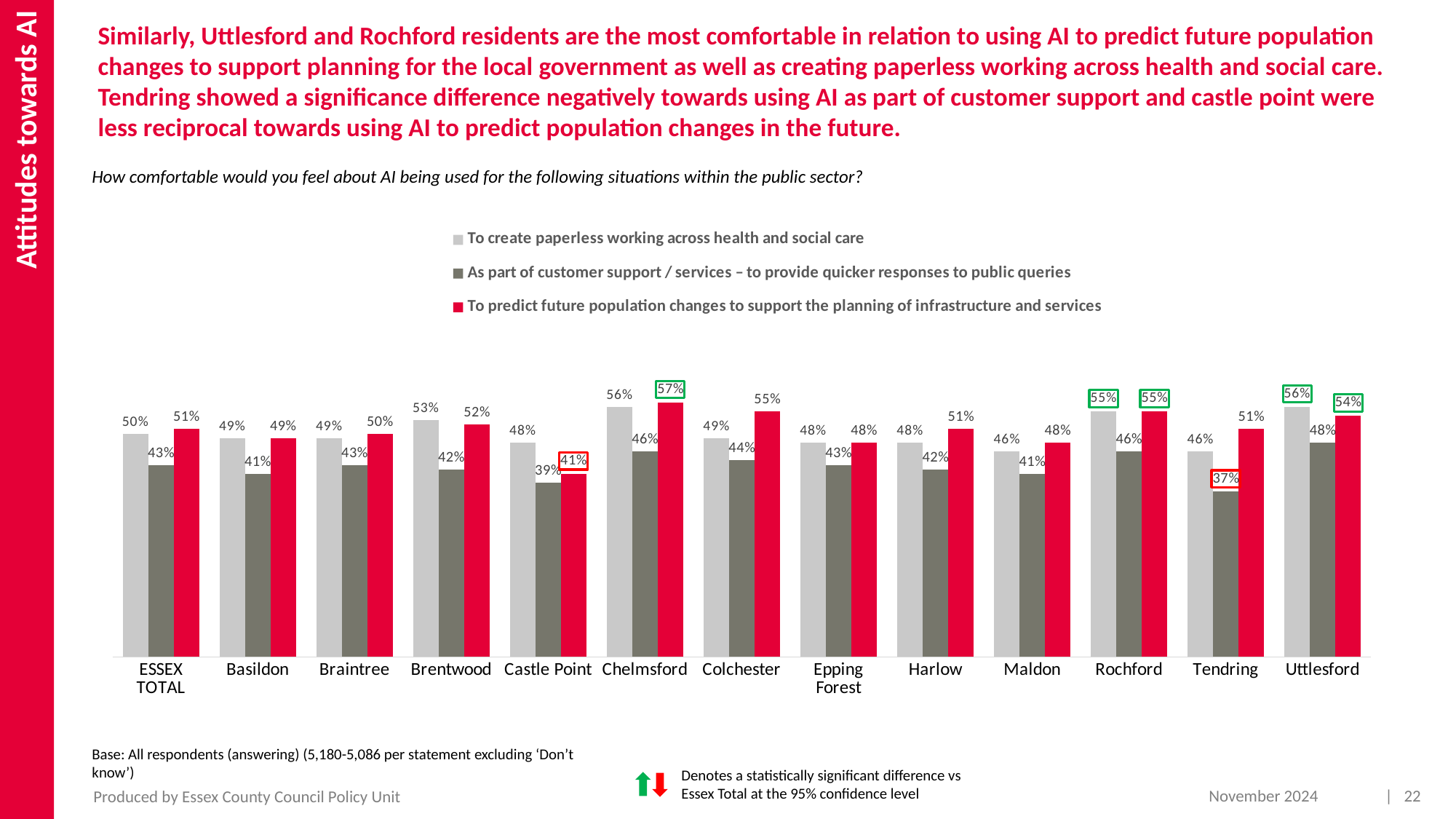
What is the value for ESSEX TOTAL for 'To create paperless working across health and social care'? 50% How many areas (categories) are shown along the x axis, including ESSEX TOTAL? 13 What kind of chart is shown on the slide? Bar chart What is the value for Tendring for 'As part of customer support / services – to provide quicker responses to public queries'? 37% Which area has the lowest value for 'As part of customer support / services – to provide quicker responses to public queries'? Tendring What is the value for Chelmsford for 'To predict future population changes to support the planning of infrastructure and services'? 57% Which colour represents 'To predict future population changes to support the planning of infrastructure and services' in the legend? Red What is the difference between Uttlesford and ESSEX TOTAL for 'As part of customer support / services – to provide quicker responses to public queries'? 5% Which area has the lowest value for 'To predict future population changes to support the planning of infrastructure and services'? Castle Point Which area has the highest value for 'To predict future population changes to support the planning of infrastructure and services'? Chelmsford How many series does the legend list? 3 Which is larger for Colchester: 'To create paperless working across health and social care' or 'To predict future population changes to support the planning of infrastructure and services'? To predict future population changes to support the planning of infrastructure and services